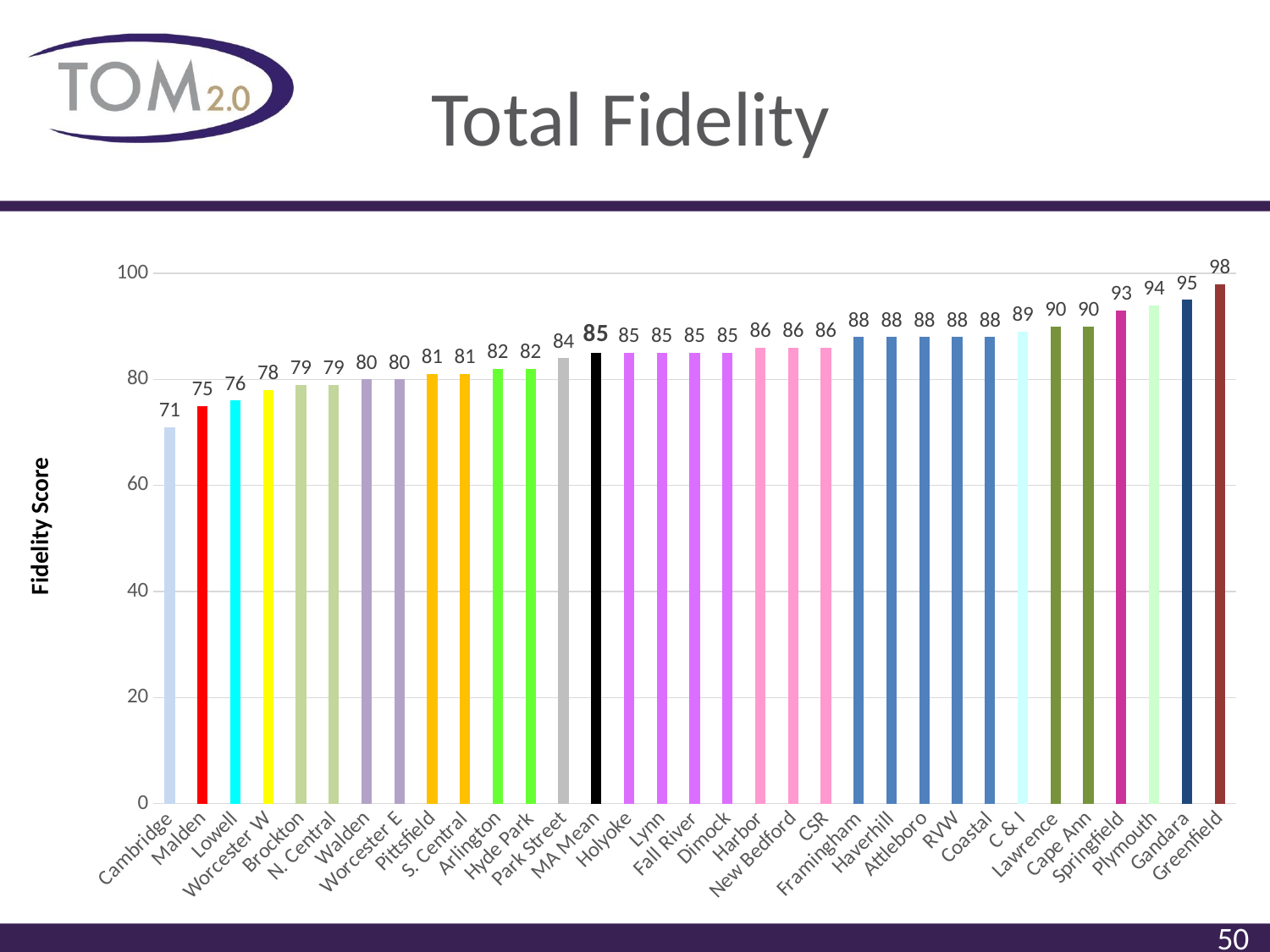
Which site has the lowest fidelity score? Cambridge What is the difference between the fidelity scores of Greenfield and Cambridge? 27 What is the fidelity score for Springfield? 93 Is the value for Lowell greater or less than 80? less Which site has the highest fidelity score? Greenfield What is the fidelity score for Cambridge? 71 What type of chart is shown on the slide? Bar chart What is the fidelity score for Greenfield? 98 How many bars are plotted in the chart? 33 What is the label on the vertical axis? Fidelity Score Which has a higher fidelity score, Malden or Plymouth? Plymouth What is the value shown for MA Mean? 85